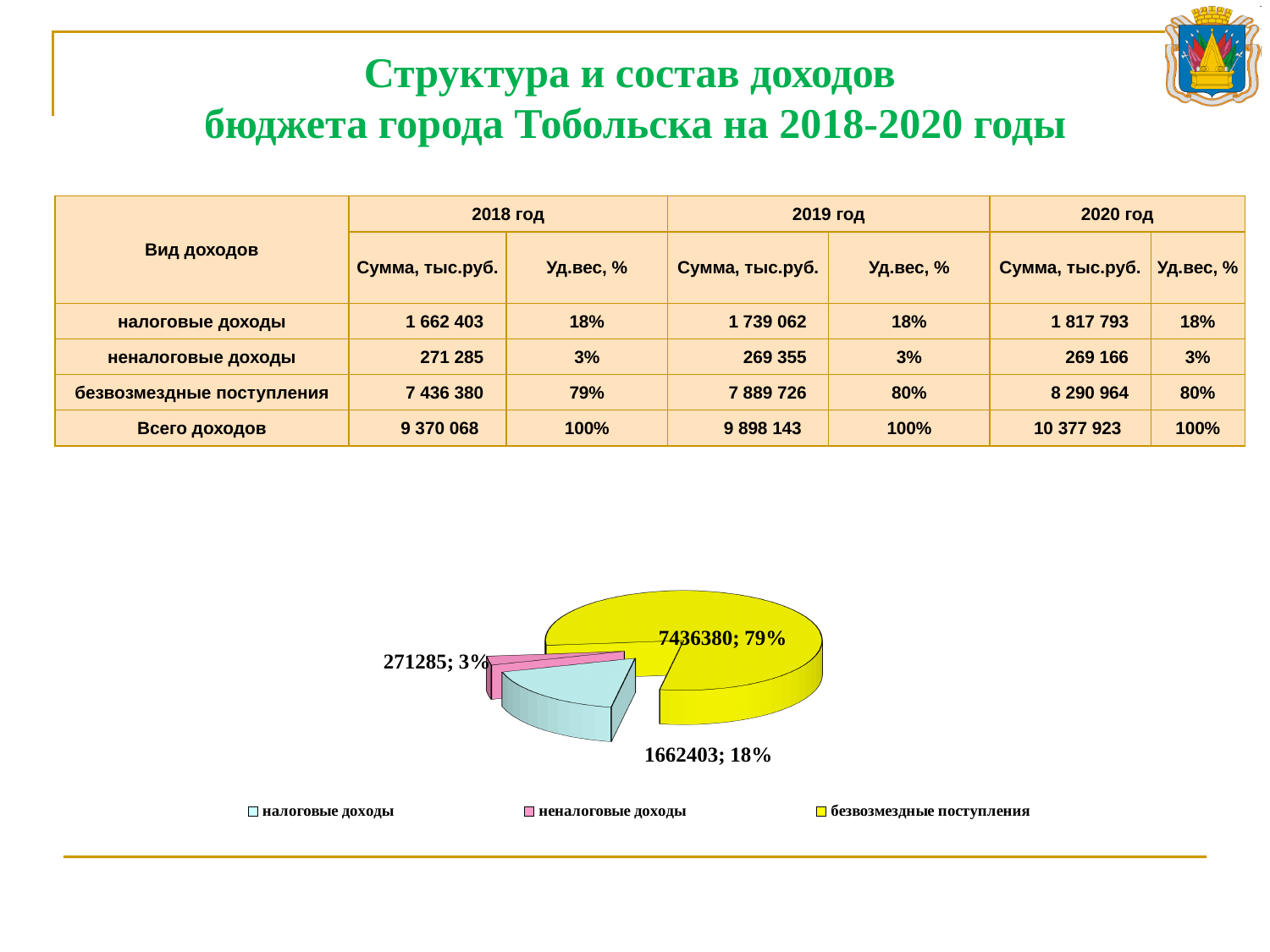
In the pie chart, what is the difference between the values for безвозмездные поступления and налоговые доходы? 5773977 In the pie chart, what share is shown for неналоговые доходы? 3% In the pie chart, what share is shown for безвозмездные поступления? 79% In the pie chart, what share is shown for налоговые доходы? 18% In the pie chart, what value is shown for налоговые доходы? 1662403 How many entries does the pie chart legend list? 3 Which category has the largest slice in the pie chart? безвозмездные поступления What kind of chart is shown on the slide? pie chart Which category has the smallest slice in the pie chart? неналоговые доходы In the pie chart, which is larger: налоговые доходы or неналоговые доходы? налоговые доходы How many slices does the pie chart have? 3 In the pie chart, what value is shown for безвозмездные поступления? 7436380